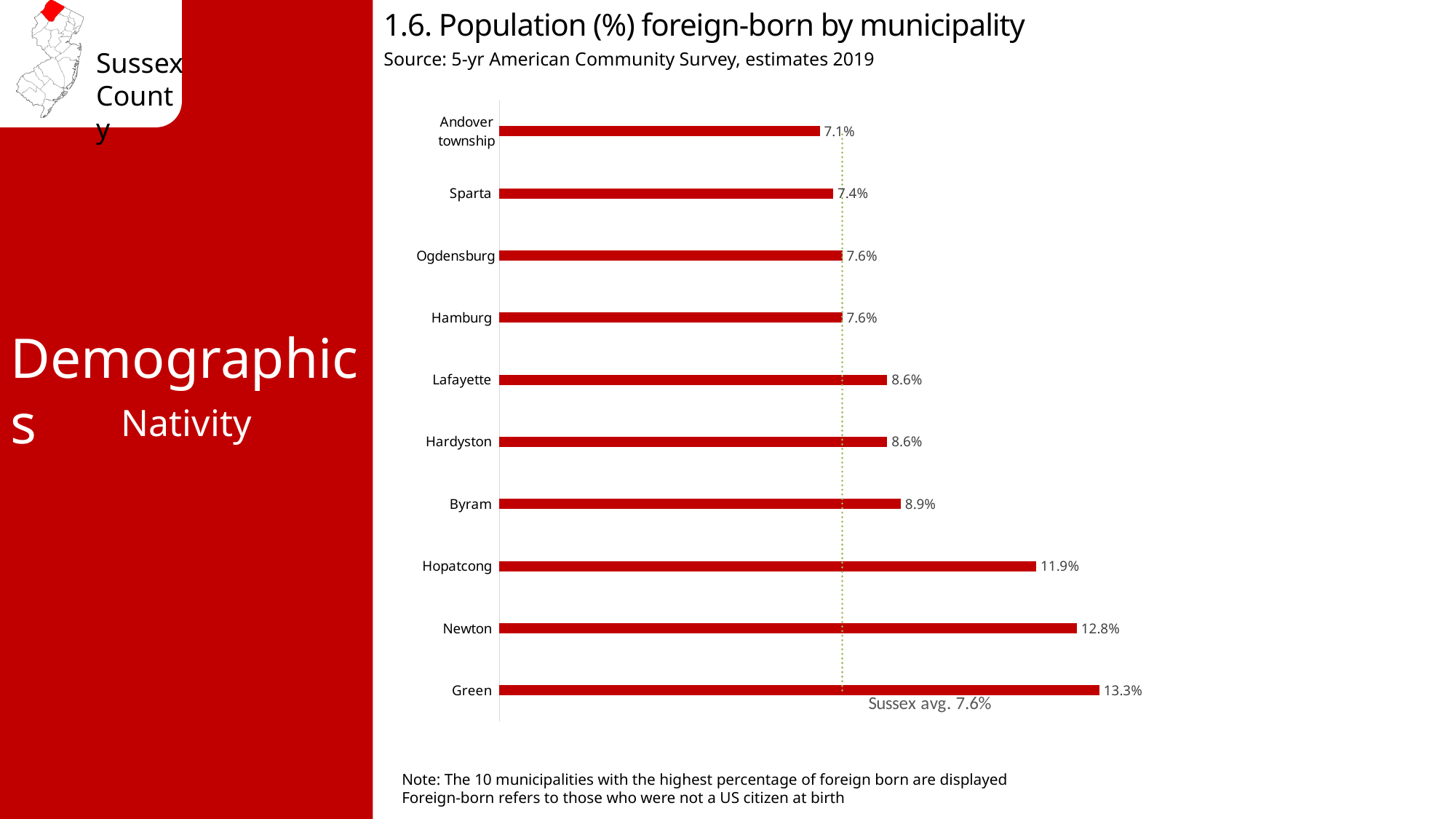
What is the difference in foreign-born percentage between Newton and Byram? 3.9% What is the source of the data shown in the chart? 5-yr American Community Survey, estimates 2019 How many municipalities are shown on the chart? 10 What is the foreign-born population percentage for Hopatcong? 11.9% Which has a higher foreign-born percentage, Hopatcong or Lafayette? Hopatcong What is the difference in foreign-born percentage between Green and Andover township? 6.2% Which municipality has the highest percentage of foreign-born population? Green What is the foreign-born population percentage for Sparta? 7.4% What is the Sussex average foreign-born percentage marked on the chart? 7.6% Which municipality has the lowest percentage of foreign-born population on the chart? Andover township What type of chart is used on this slide? Bar chart What is the foreign-born population percentage for Green? 13.3%